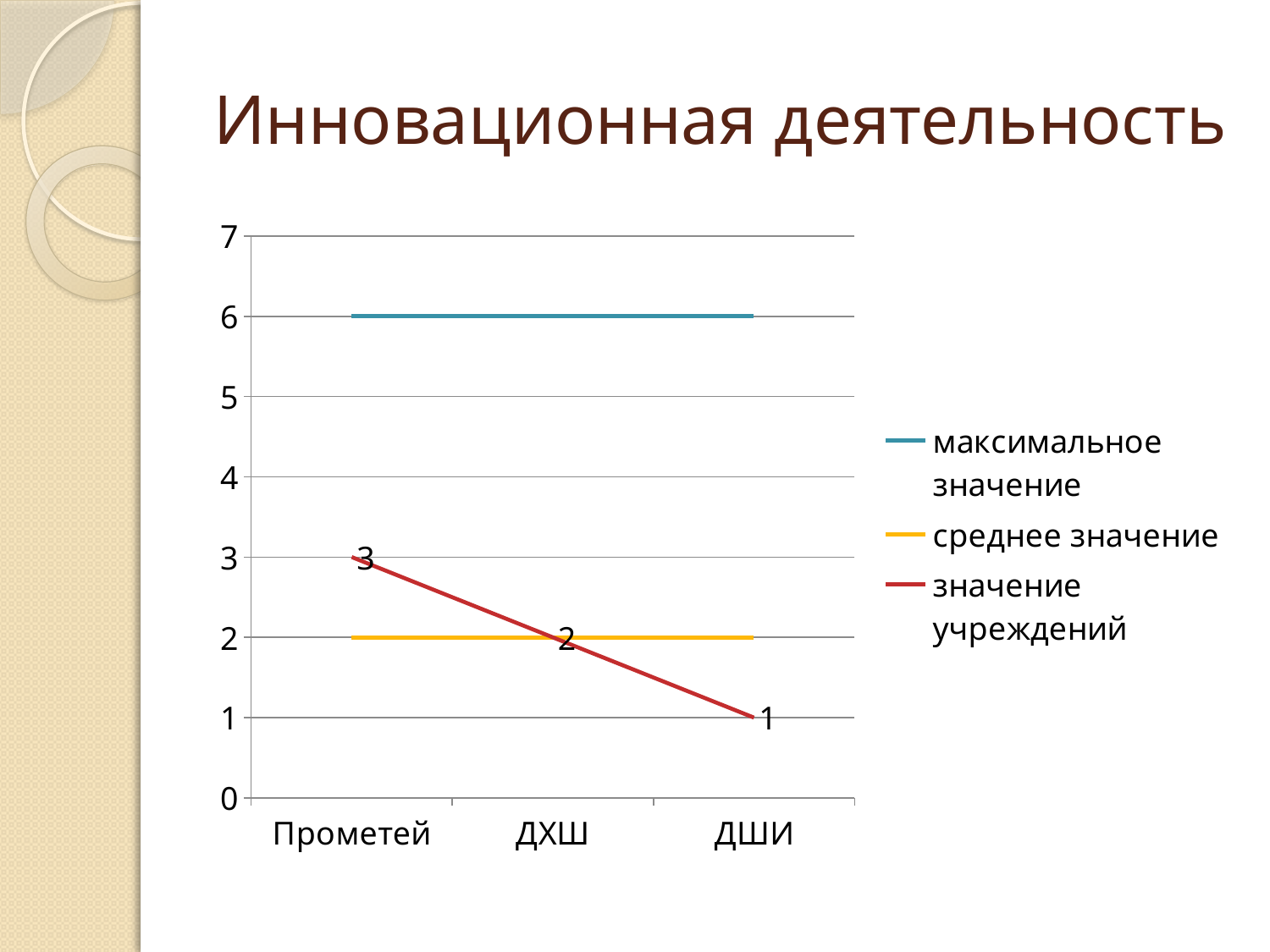
What value does the среднее значение line sit at? 2 What value does the максимальное значение line sit at? 6 How many categories are shown on the x axis? 3 What is the difference between the значение учреждений values for Прометей and ДШИ? 2 Which category has the highest value in the значение учреждений series? Прометей Does the значение учреждений series rise or fall from Прометей to ДШИ? fall What is the value for ДШИ in the значение учреждений series? 1 What is the value for ДХШ in the значение учреждений series? 2 How many series does the legend list? 3 What is the value for Прометей in the значение учреждений series? 3 Which is larger: the значение учреждений value for Прометей or for ДХШ? Прометей Which category has the lowest value in the значение учреждений series? ДШИ